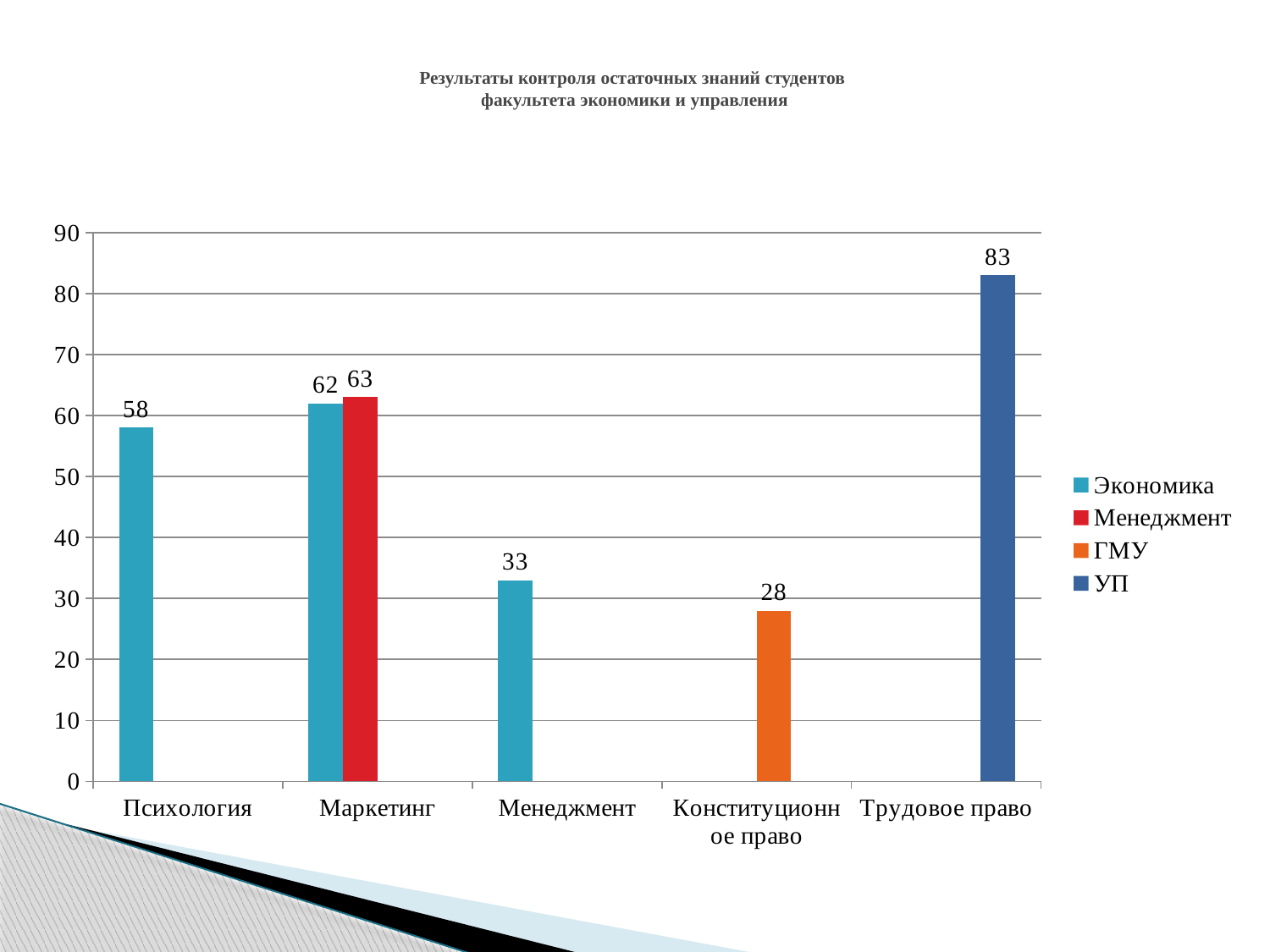
What is the value for Менеджмент in the Маркетинг category? 63 What is the value for УП in the Трудовое право category? 83 What kind of chart is shown on the slide? bar chart Which category has the highest plotted value? Трудовое право Which category has the lowest plotted value? Конституционное право What is the value for ГМУ in the Конституционное право category? 28 What is the difference between the УП value for Трудовое право and the Экономика value for Менеджмент? 50 Which is larger: the Экономика value for Психология or the Экономика value for Менеджмент? Психология Is the Экономика value for Маркетинг greater or less than 60? greater How many categories are shown on the x axis? 5 What is the value for Экономика in the Психология category? 58 How many series does the legend list? 4